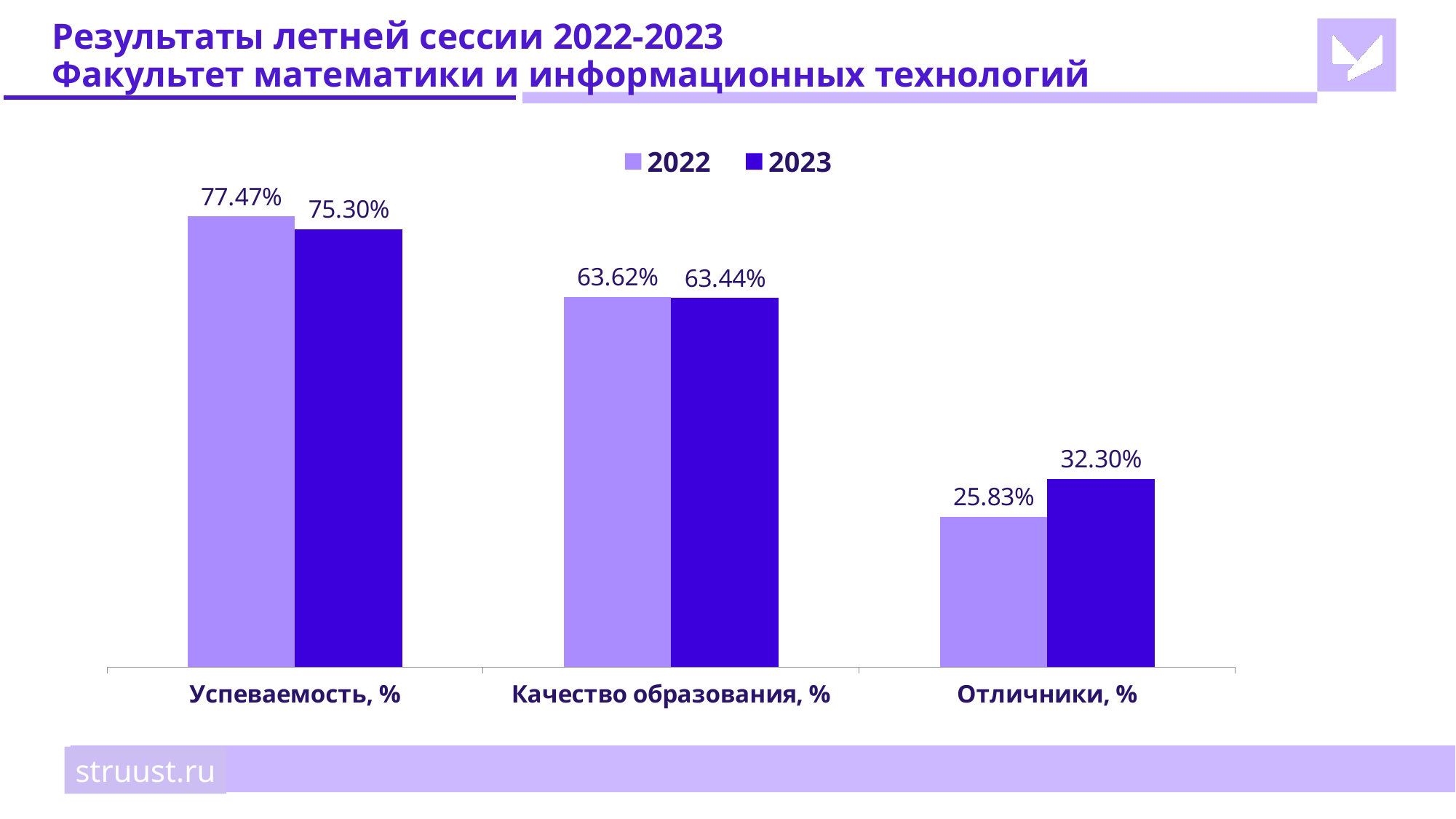
What is the difference between the 2023 and 2022 values for Отличники, %? 6.47% Which category has the highest value in 2023? Успеваемость, % What is the value for Отличники, % in 2023? 32.30% Which is larger for Отличники, %: the 2022 value or the 2023 value? 2023 What kind of chart is shown on the slide? Bar chart Which category has the lowest value in 2022? Отличники, % What is the value for Качество образования, % in 2023? 63.44% What is the value for Успеваемость, % in 2022? 77.47% How many series does the legend list? 2 What is the difference between the 2022 and 2023 values for Успеваемость, %? 2.17% How many categories are shown on the x axis? 3 Which series is shown in the darker purple colour? 2023